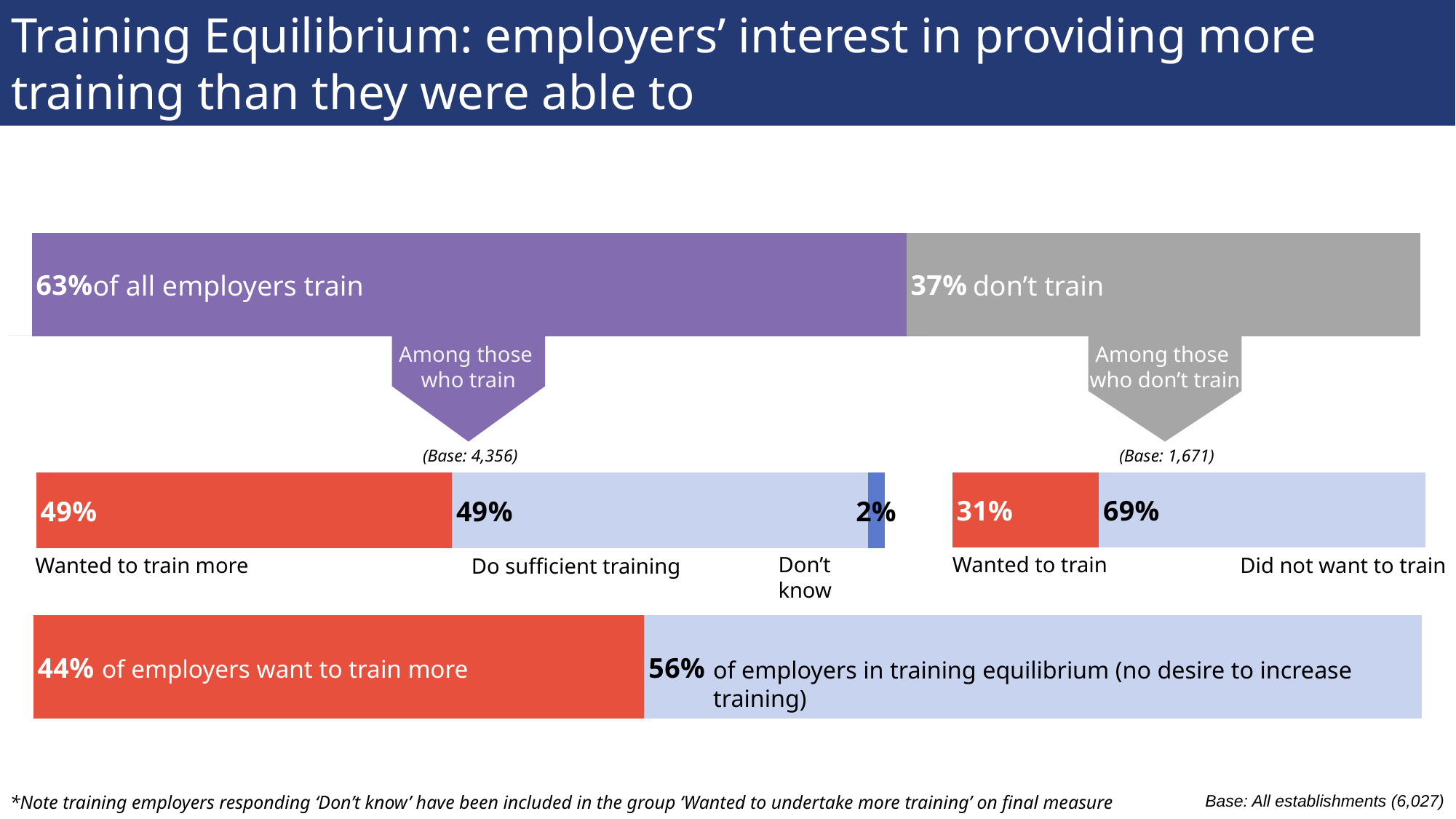
In the top bar, what percentage of employers don't train? 37% How many segments does the 'Among those who train' bar have? 3 In the bottom bar, what percentage of employers want to train more? 44% In the top bar, what percentage of all employers train? 63% In the 'Among those who train' bar, what percentage wanted to train more? 49% In the 'Among those who don't train' bar, which segment is larger: 'Wanted to train' or 'Did not want to train'? Did not want to train What is the base (number of respondents) shown for the 'Among those who train' bar? 4,356 In the bottom bar, what percentage of employers are in training equilibrium? 56% In the 'Among those who don't train' bar, what percentage wanted to train? 31% In the 'Among those who train' bar, what percentage answered 'Don't know'? 2% In the 'Among those who don't train' bar, what is the difference between 'Did not want to train' and 'Wanted to train'? 38 percentage points In the 'Among those who train' bar, which segment is the smallest? Don't know